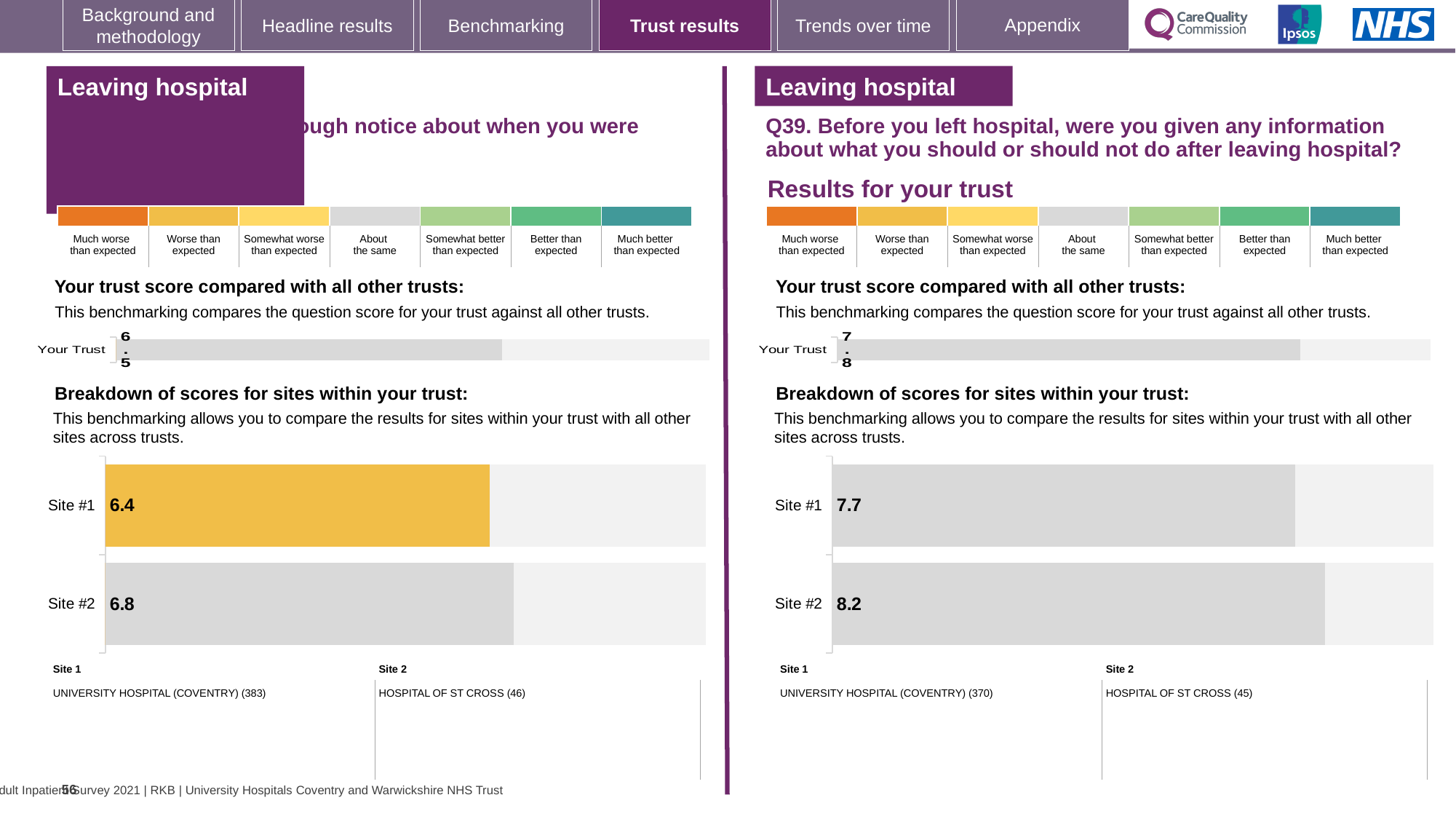
In the Q39 (right half) site breakdown chart, what is the difference between the Site #2 and Site #1 scores? 0.5 In the Q39 (right half) site breakdown chart, what is the score for Site #1? 7.7 On the left half of the slide, what is the difference between the Site #2 and Site #1 scores in the site breakdown chart? 0.4 In the Q39 (right half) site breakdown chart, which site has the higher score? Site #2 On the left half of the slide, what is the score shown for Site #2 in the breakdown of scores for sites within your trust? 6.8 How many sites are shown in the Q39 (right half) site breakdown chart? 2 On the left half of the slide, what is the 'Your Trust' score in the trust score comparison chart? 6.5 What type of chart is used for the site breakdown on the left half of the slide? Bar chart On the left half of the slide, which site has the lower score in the site breakdown chart? Site #1 In the Q39 (right half) site breakdown chart, what is the score for Site #2? 8.2 In the Q39 (right half) trust score comparison chart, what is the 'Your Trust' score? 7.8 On the left half of the slide, what is the score shown for Site #1 in the breakdown of scores for sites within your trust? 6.4